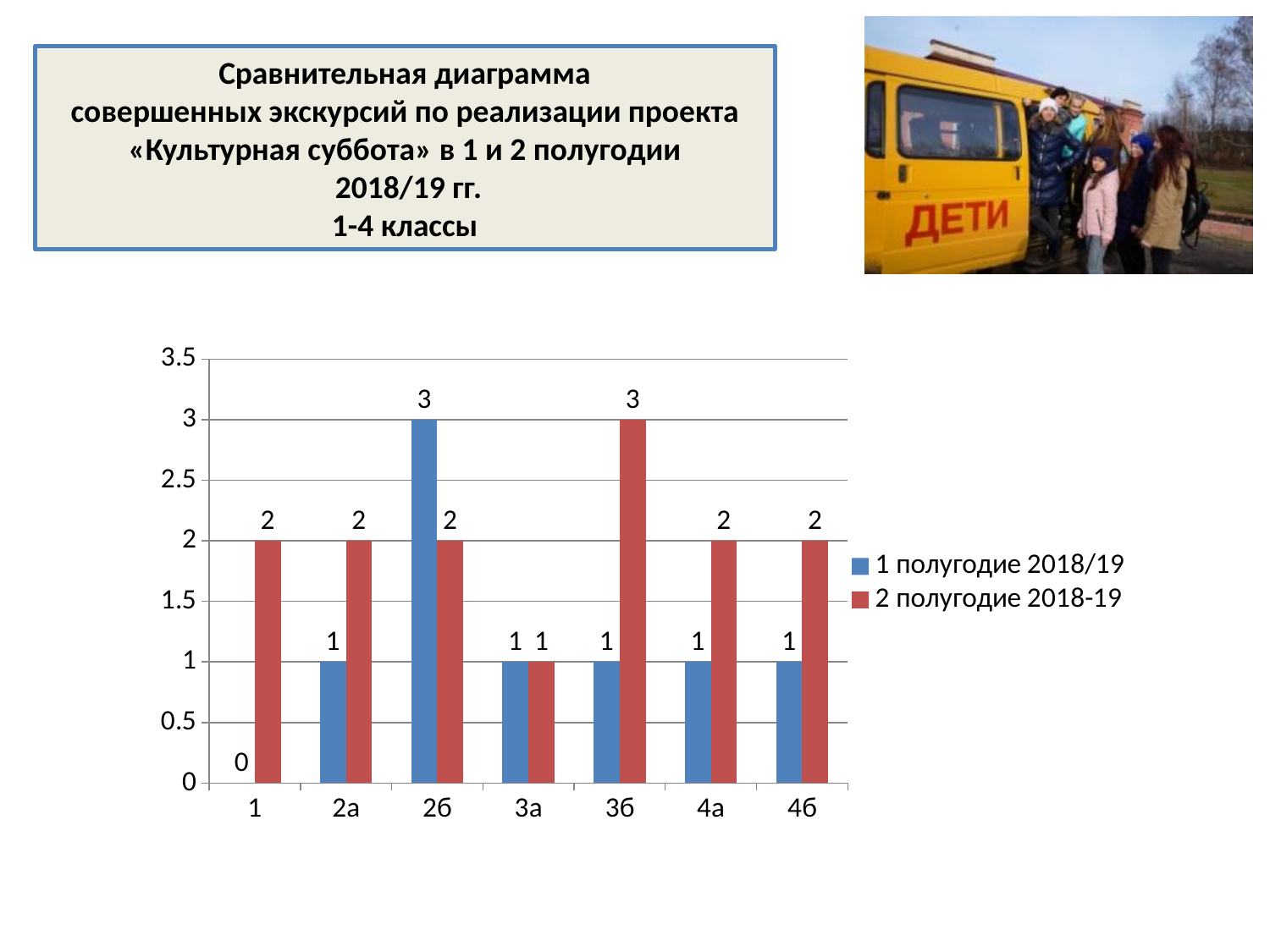
Which class has the highest value in the 1 полугодие 2018/19 series? 2б What is the difference between the 2 полугодие 2018-19 and 1 полугодие 2018/19 values for class 3б? 2 Which class has the lowest value in the 1 полугодие 2018/19 series? 1 What is the value for class 2б in the 1 полугодие 2018/19 series? 3 What type of chart is shown on the slide? bar chart How many series does the legend list? 2 What is the value for class 1 in the 1 полугодие 2018/19 series? 0 What is the value for class 3б in the 2 полугодие 2018-19 series? 3 For class 2б, which series has the larger value: 1 полугодие 2018/19 or 2 полугодие 2018-19? 1 полугодие 2018/19 What is the value for class 4а in the 2 полугодие 2018-19 series? 2 Which class has the highest value in the 2 полугодие 2018-19 series? 3б How many class categories are shown on the x axis? 7